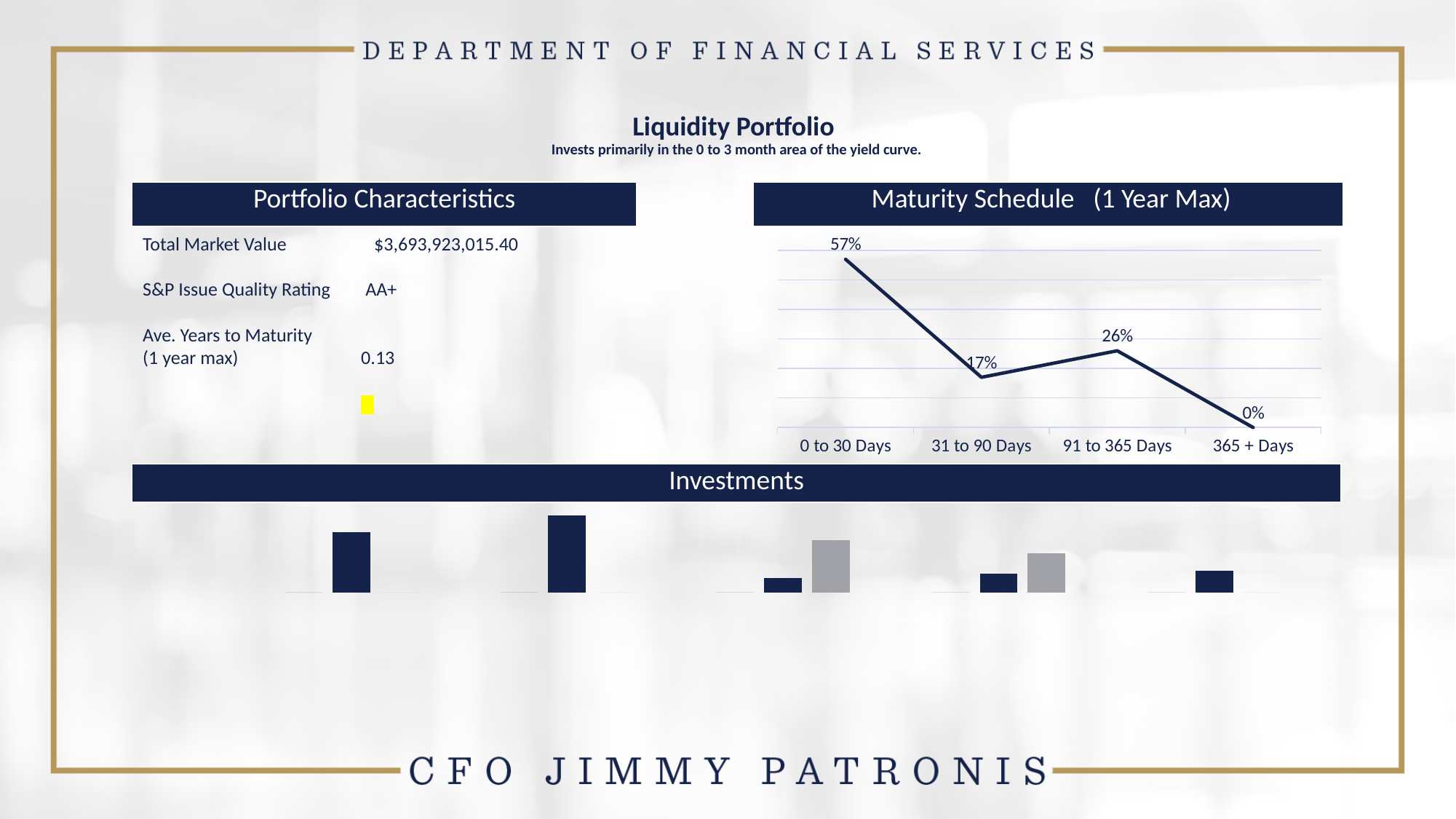
In the Maturity Schedule chart, what is the difference between the values for 0 to 30 Days and 31 to 90 Days? 40% In the Maturity Schedule chart, which maturity bucket has the highest value? 0 to 30 Days In the Maturity Schedule chart, what is the value for 365 + Days? 0% How many maturity buckets are plotted in the Maturity Schedule chart? 4 What kind of chart is the Maturity Schedule chart? Line chart In the Maturity Schedule chart, what is the difference between the values for 91 to 365 Days and 31 to 90 Days? 9% In the Maturity Schedule chart, what is the value for 91 to 365 Days? 26% In the Maturity Schedule chart, what is the value for 31 to 90 Days? 17% What kind of chart is shown under the Investments heading? Bar chart In the Maturity Schedule chart, what is the value for 0 to 30 Days? 57% In the Maturity Schedule chart, which maturity bucket has the lowest value? 365 + Days In the Maturity Schedule chart, which is larger: the value for 31 to 90 Days or the value for 91 to 365 Days? 91 to 365 Days